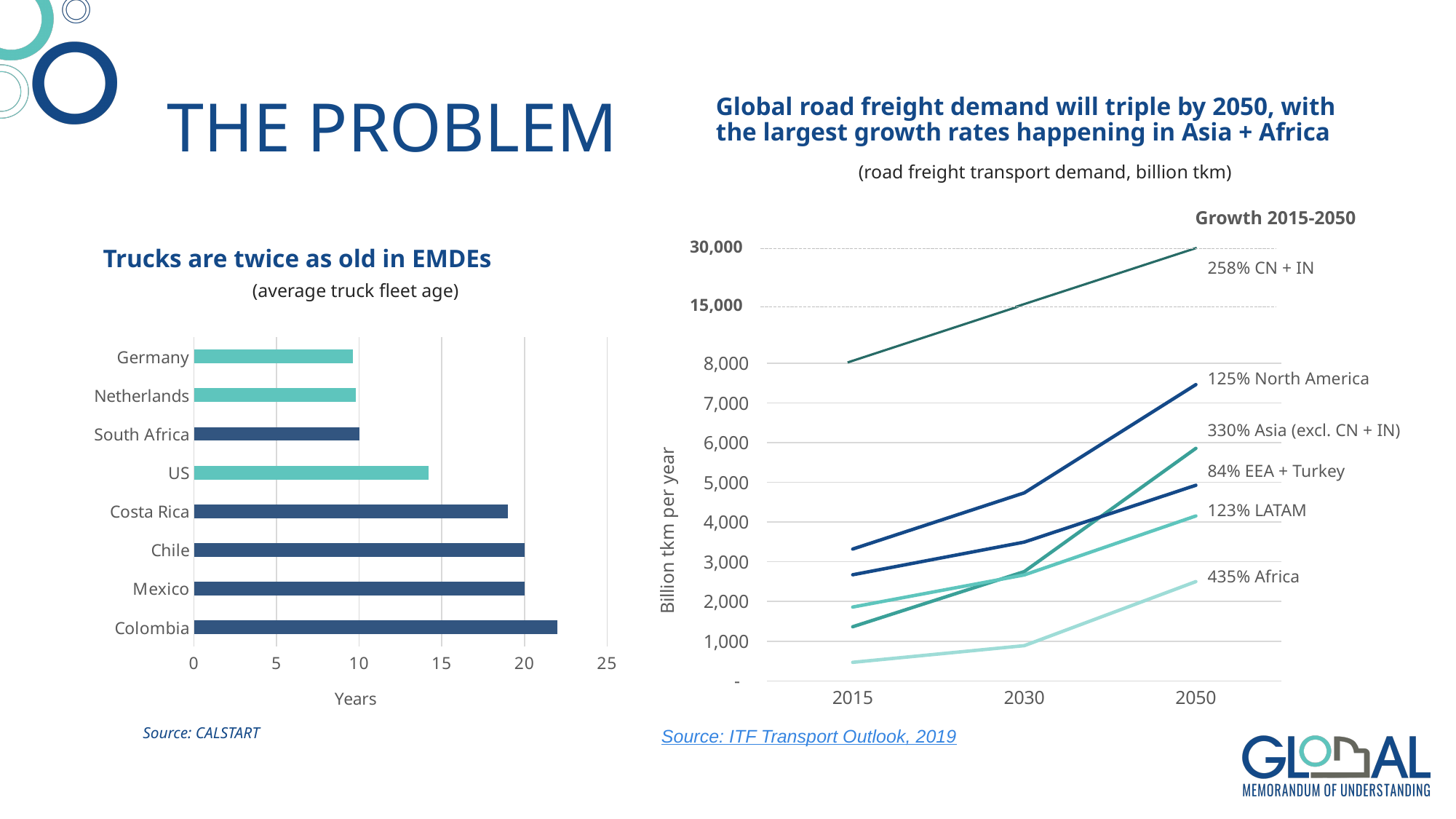
What kind of chart is the 'Global road freight demand will triple by 2050' chart? line chart In the 'Global road freight demand will triple by 2050' chart, what is the growth 2015-2050 shown for EEA + Turkey? 84% In the 'Global road freight demand will triple by 2050' chart, how many regions (lines) are plotted? 6 In the 'Trucks are twice as old in EMDEs' chart, is the value for US greater or less than 15 years? less In the 'Global road freight demand will triple by 2050' chart, do the lines rise or fall from 2015 to 2050? rise In the 'Trucks are twice as old in EMDEs' chart, which country has the highest average truck fleet age? Colombia In the 'Global road freight demand will triple by 2050' chart, which region has the highest growth rate for 2015-2050? Africa (435%) How many countries are shown in the 'Trucks are twice as old in EMDEs' chart? 8 In the 'Trucks are twice as old in EMDEs' chart, is the value for Colombia greater or less than 20 years? greater In the 'Trucks are twice as old in EMDEs' chart, is the value for Costa Rica greater or less than 15 years? greater What kind of chart is the 'Trucks are twice as old in EMDEs' chart? bar chart In the 'Trucks are twice as old in EMDEs' chart, which is larger, the value for Chile or the value for Germany? Chile